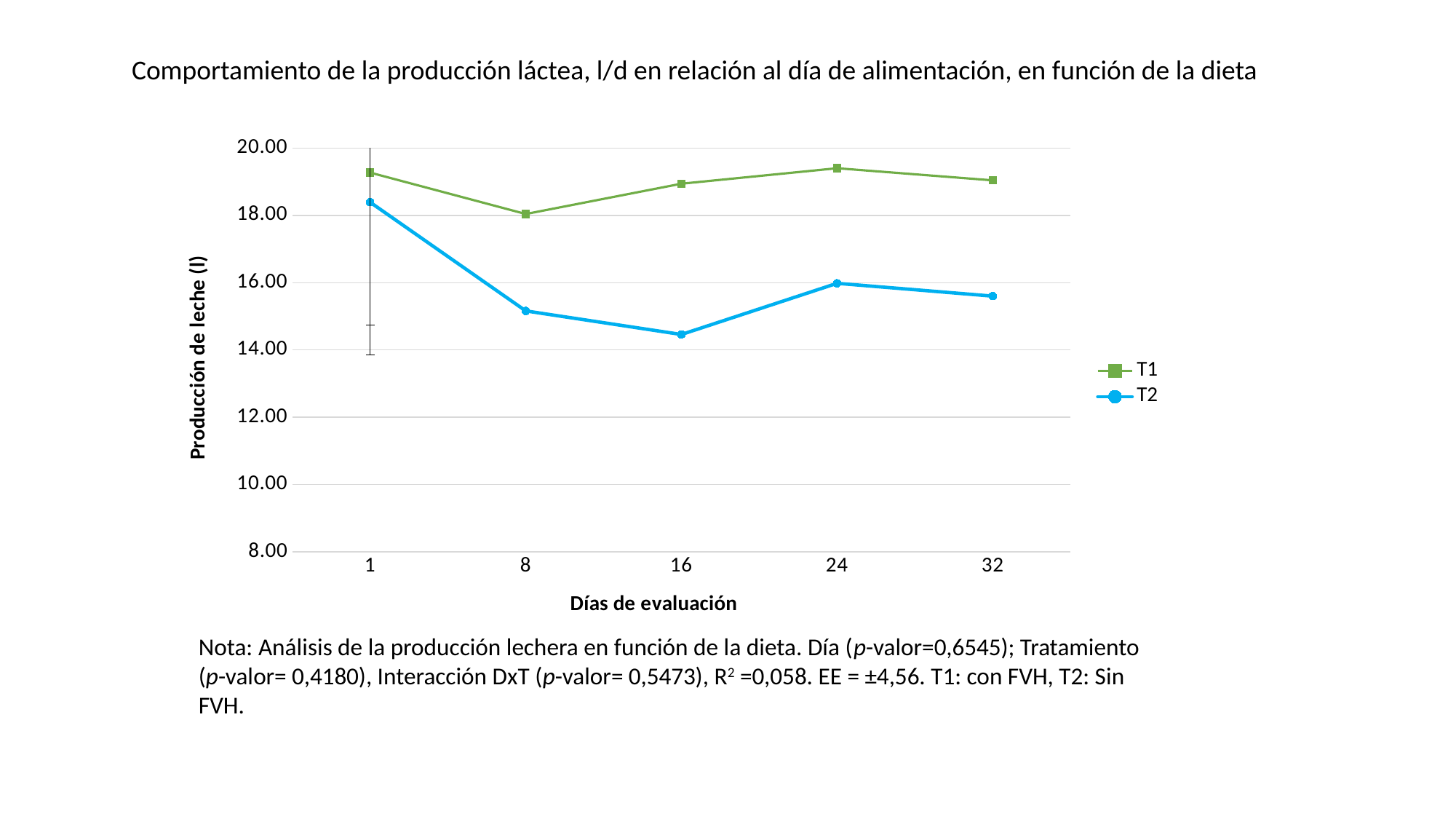
Is the value for T2 on day 1 greater or less than 18.00? greater Is the value for T2 on day 16 greater or less than 16.00? less Is the value for T2 on day 8 greater or less than 16.00? less On which evaluation day is the T1 series at its lowest? 8 Does the T2 series rise or fall from day 1 to day 16? fall How many evaluation days are plotted along the x axis? 5 What kind of chart is shown on the slide? line chart On day 16, which series has the higher milk production, T1 or T2? T1 How many series does the legend list? 2 On which evaluation day is the T2 series at its highest? 1 On which evaluation day is the T2 series at its lowest? 16